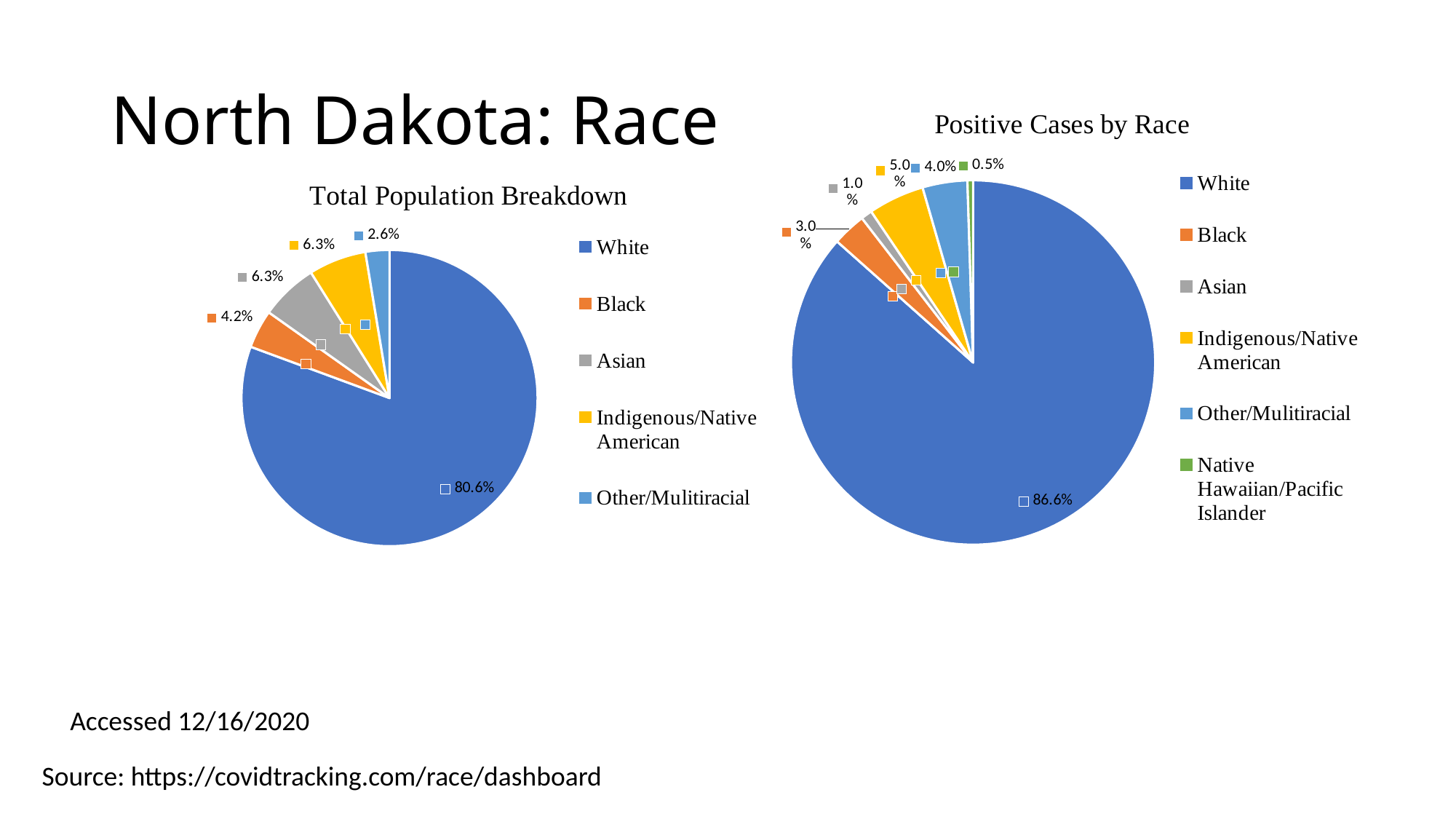
In the Total Population Breakdown chart, which category has the smallest slice? Other/Mulitiracial What is the difference between the White share in the Positive Cases by Race chart and the White share in the Total Population Breakdown chart? 6.0% In the Positive Cases by Race chart, what is the value for Native Hawaiian/Pacific Islander? 0.5% What type of chart is the Positive Cases by Race chart? Pie chart How many categories does the legend of the Positive Cases by Race chart list? 6 In the Positive Cases by Race chart, what percentage of positive cases are Black? 3.0% In the Positive Cases by Race chart, which is larger: the Indigenous/Native American slice or the Other/Mulitiracial slice? Indigenous/Native American In the Total Population Breakdown chart, what is the value for Other/Mulitiracial? 2.6% How many slices does the Total Population Breakdown chart have? 5 In the Total Population Breakdown chart, what share of the population is White? 80.6% In the Positive Cases by Race chart, which category has the smallest slice? Native Hawaiian/Pacific Islander In the Total Population Breakdown chart, which category has the largest slice? White